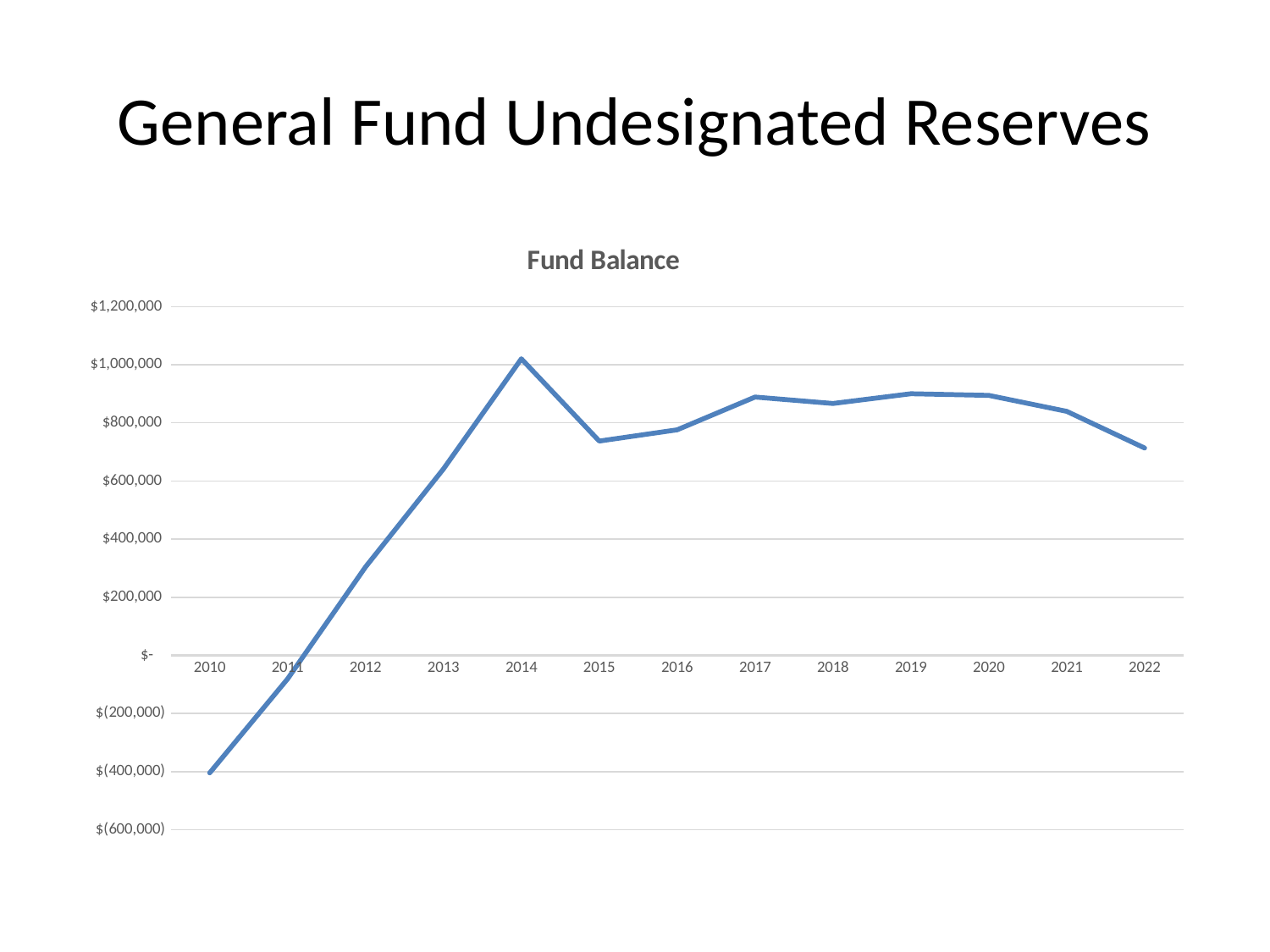
Does the fund balance rise or fall from 2010 to 2014? rise What is the title of the chart? Fund Balance Which year has the lowest fund balance? 2010 Which year has the highest fund balance? 2014 What kind of chart is shown on the slide? line chart Is the fund balance for 2015 greater or less than $800,000? less Which year has a larger fund balance, 2021 or 2022? 2021 Is the fund balance for 2022 greater or less than $800,000? less Is the fund balance for 2014 greater or less than $800,000? greater Which year has a larger fund balance, 2014 or 2015? 2014 How many years are plotted on the x axis? 13